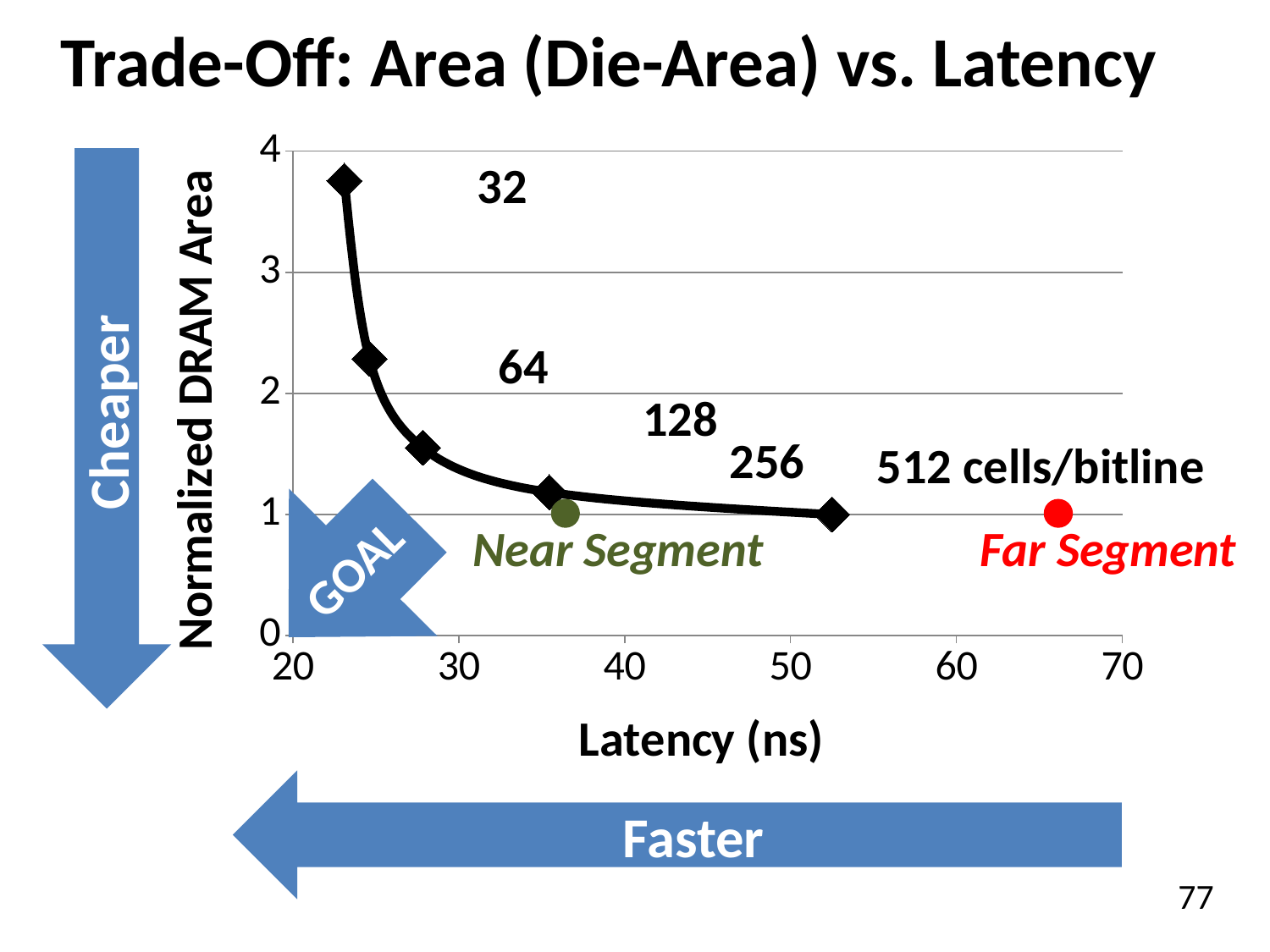
What is the title of the chart on the slide? Trade-Off: Area (Die-Area) vs. Latency Which has a higher latency, the Near Segment or the Far Segment? Far Segment Which has a larger normalized DRAM area, 128 cells/bitline or 256 cells/bitline? 128 Is the normalized DRAM area for 32 cells/bitline greater or less than 3? greater Which cells/bitline configuration has the highest normalized DRAM area? 32 Is the normalized DRAM area for 64 cells/bitline greater or less than 2? greater How many labeled cells/bitline points are plotted on the black curve? 5 Which cells/bitline configuration has the lowest normalized DRAM area? 512 Is the latency for 512 cells/bitline greater or less than 50 ns? greater What is the label of the x axis? Latency (ns) As latency increases along the x axis, does the normalized DRAM area rise or fall? fall